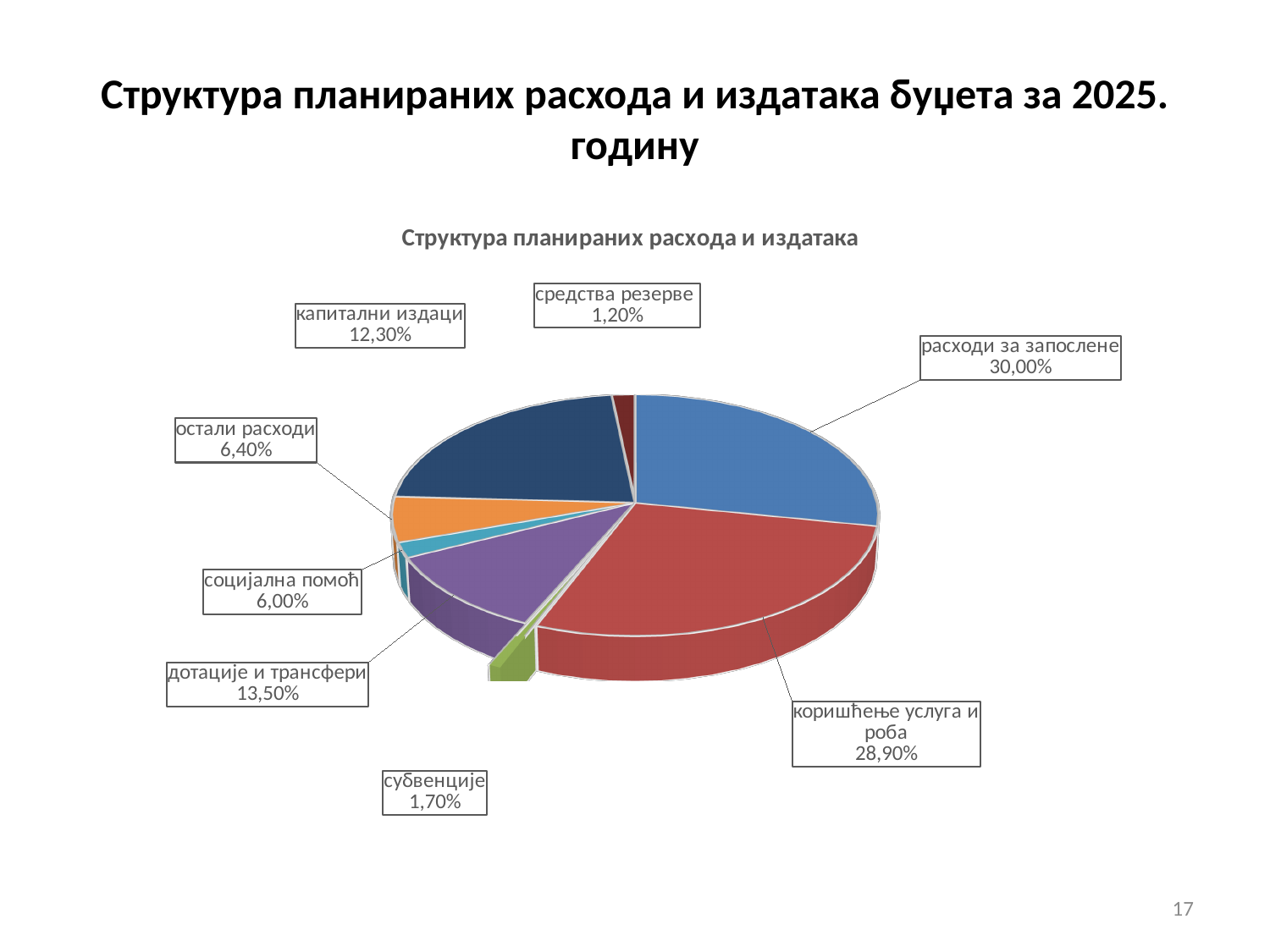
Which is larger, the share for остали расходи or the share for социјална помоћ? остали расходи What share is shown for средства резерве? 1,20% What share is shown for коришћење услуга и роба? 28,90% What share is shown for дотације и трансфери? 13,50% Which category has the largest share of the pie? расходи за запослене How many slices does the pie chart have? 8 What is the title of the chart? Структура планираних расхода и издатака What share is shown for капитални издаци? 12,30% What is the difference in percentage points between расходи за запослене and коришћење услуга и роба? 1,10 What type of chart is shown on the slide? pie chart What share is shown for расходи за запослене? 30,00%